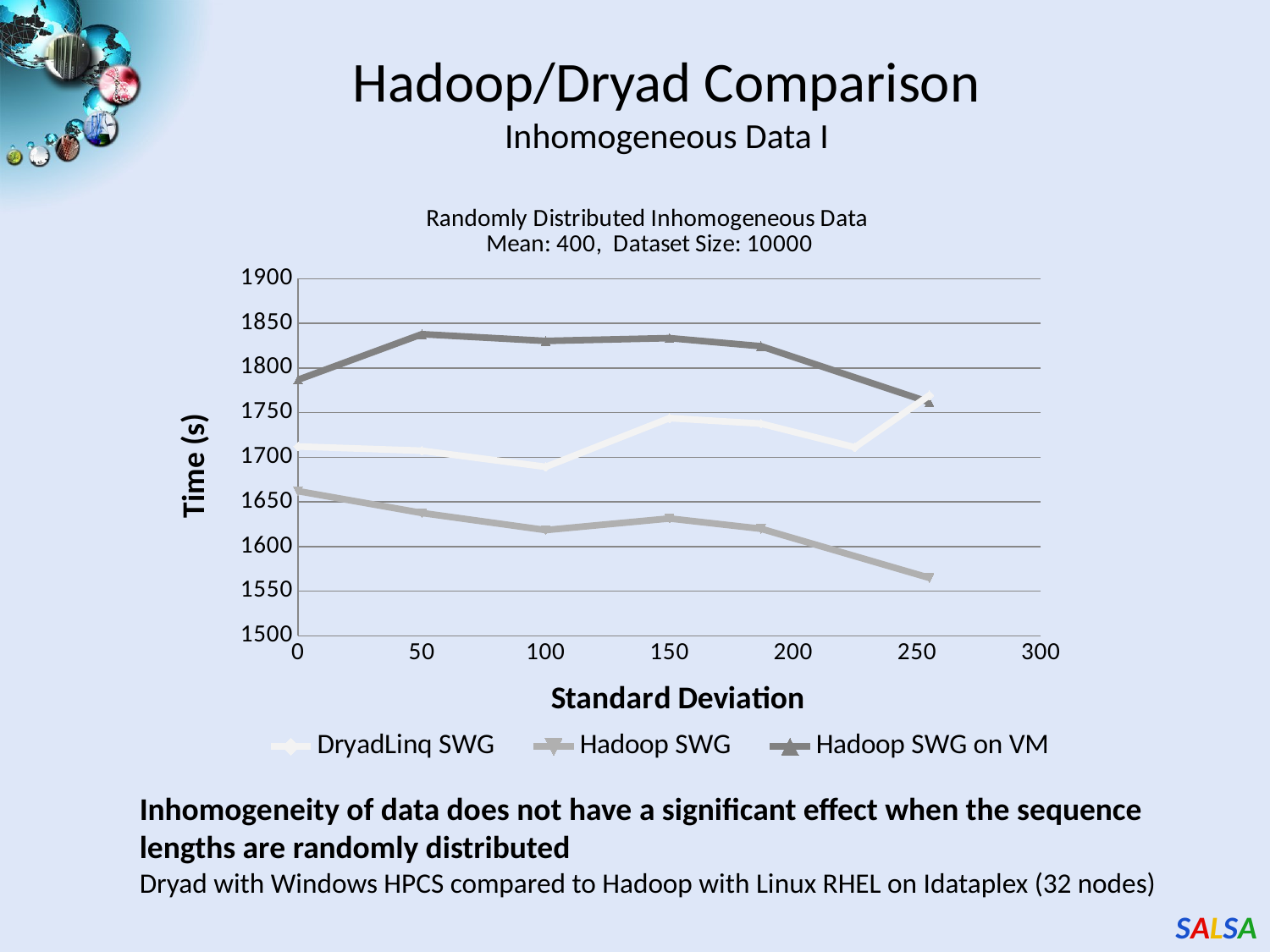
Is the value for DryadLinq SWG at Standard Deviation 100 greater or less than 1700? less What is the label of the y axis? Time (s) Which series has the highest Time (s) values across the chart? Hadoop SWG on VM Which series has the lowest Time (s) values across the chart? Hadoop SWG At Standard Deviation 0, which series has the larger Time (s): DryadLinq SWG or Hadoop SWG? DryadLinq SWG Is the value for Hadoop SWG on VM at Standard Deviation 50 greater or less than 1800? greater Is the value for Hadoop SWG on VM at Standard Deviation 0 greater or less than 1800? less What is the label of the x axis? Standard Deviation Does the Hadoop SWG line generally rise or fall as Standard Deviation increases? fall How many series does the legend list? 3 What kind of chart is shown on the slide? Line chart